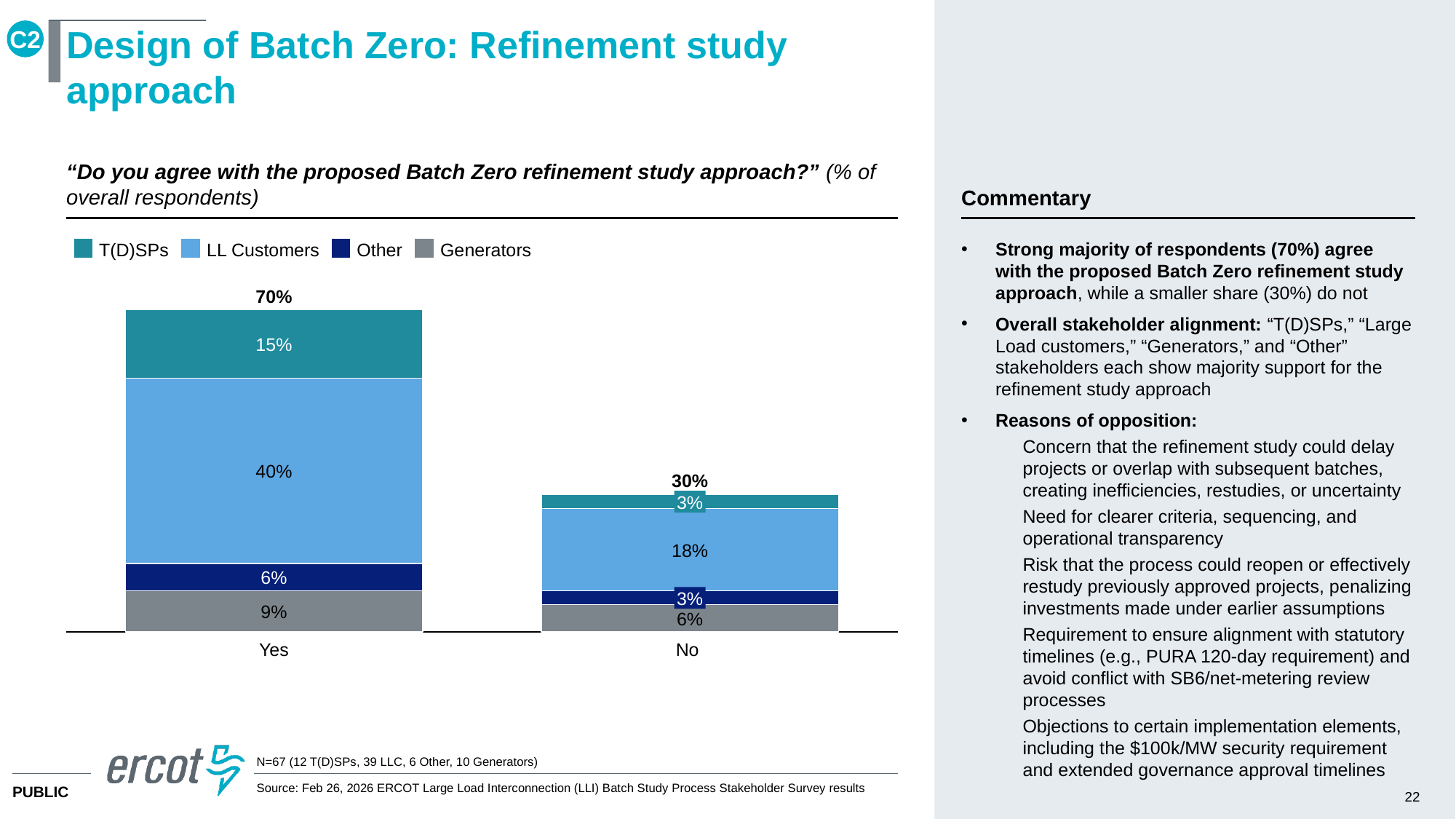
What is the difference between the LL Customers values for Yes and No? 22% How many series does the legend list? 4 What is the total for the No bar? 30% What is the Generators value for Yes? 9% What is the difference between the Yes and No totals? 40% What is the T(D)SPs value for No? 3% What is the total for the Yes bar? 70% What kind of chart is shown? Stacked bar chart What is the LL Customers value for Yes? 40% Which category has the higher total, Yes or No? Yes How many categories are shown on the x axis? 2 What is the Other value for No? 3%